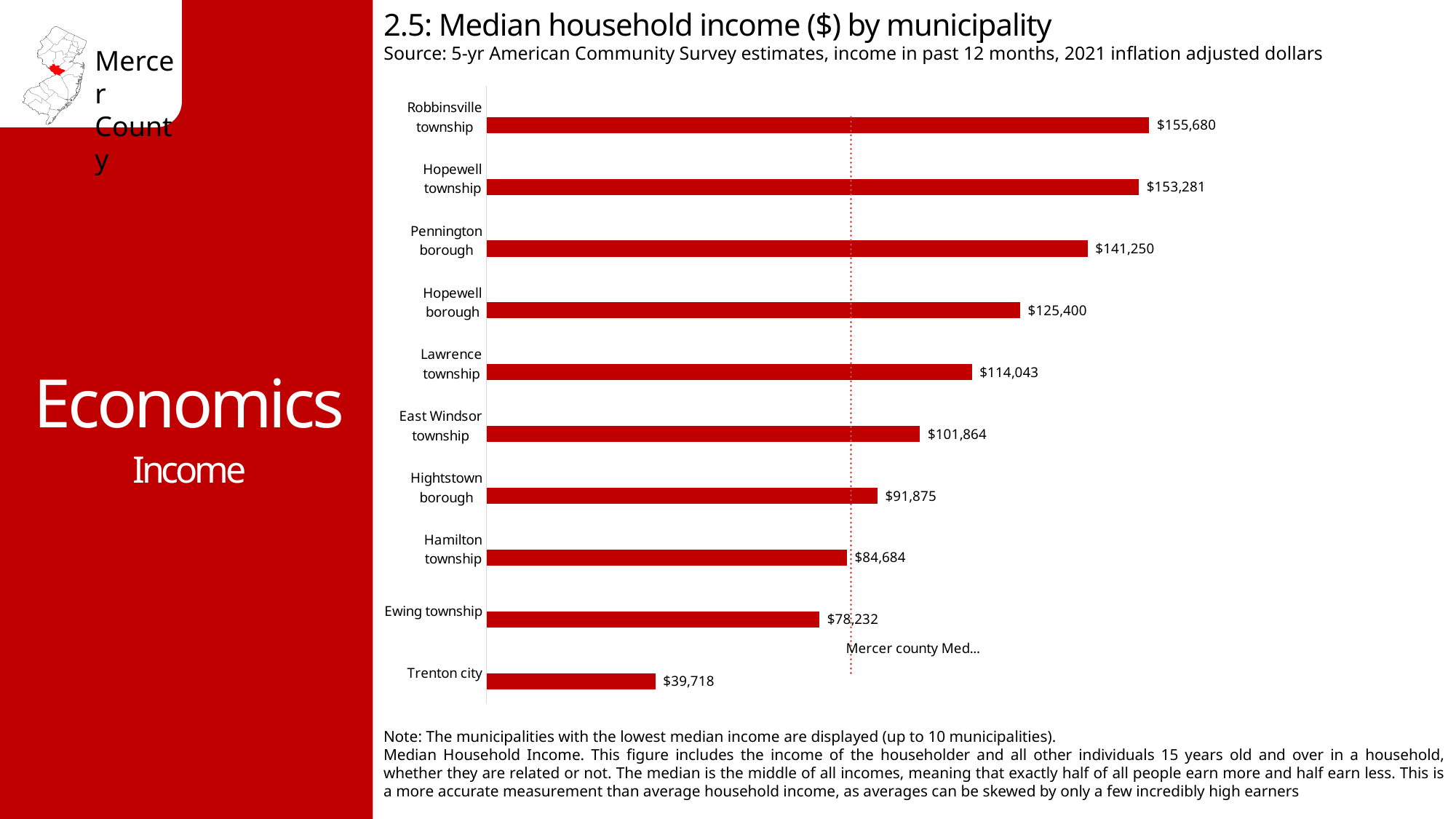
How many municipalities are shown in the chart? 10 Which municipality has the lowest median household income? Trenton city What is the median household income for Hightstown borough? $91,875 What type of chart is used to show median household income by municipality? Bar chart What is the median household income for Robbinsville township? $155,680 What is the median household income for Lawrence township? $114,043 What does the dotted vertical line on the chart represent? Mercer county median Which has a higher median household income, East Windsor township or Hamilton township? East Windsor township What is the difference in median household income between Pennington borough and Hopewell borough? $15,850 What is the difference in median household income between Ewing township and Trenton city? $38,514 What is the median household income for Trenton city? $39,718 Which municipality has the highest median household income? Robbinsville township